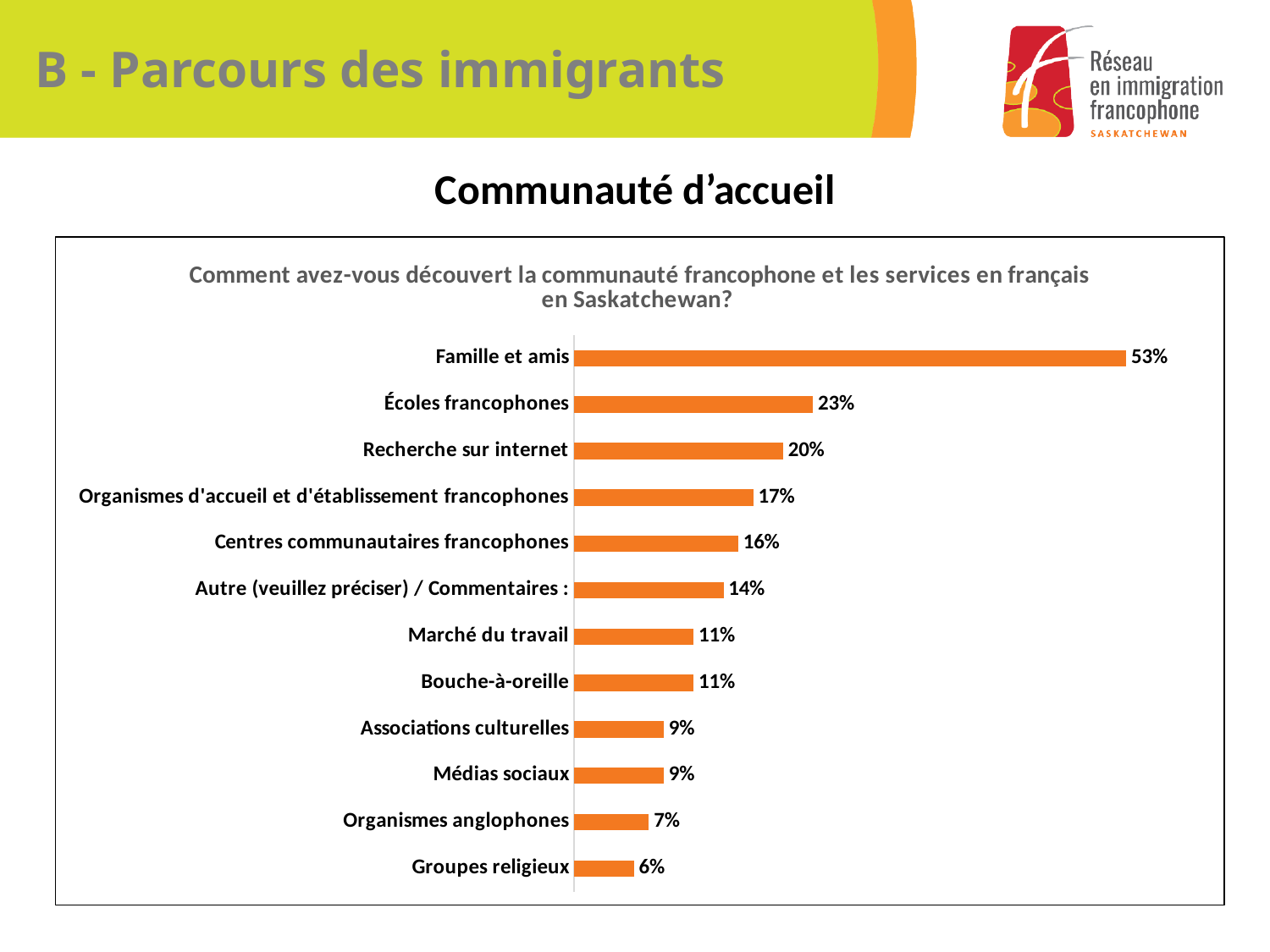
How many categories are shown in the chart? 12 Which category has the lowest value? Groupes religieux What is the value for Organismes anglophones? 7% Which category has the highest value? Famille et amis What is the title of the chart? Comment avez-vous découvert la communauté francophone et les services en français en Saskatchewan? Which is larger, Marché du travail or Associations culturelles? Marché du travail What kind of chart is shown on the slide? Bar chart What is the value for Recherche sur internet? 20% What is the difference between Centres communautaires francophones and Médias sociaux? 7% Which is larger, Écoles francophones or Recherche sur internet? Écoles francophones What is the value for Famille et amis? 53% What is the difference between Famille et amis and Écoles francophones? 30%